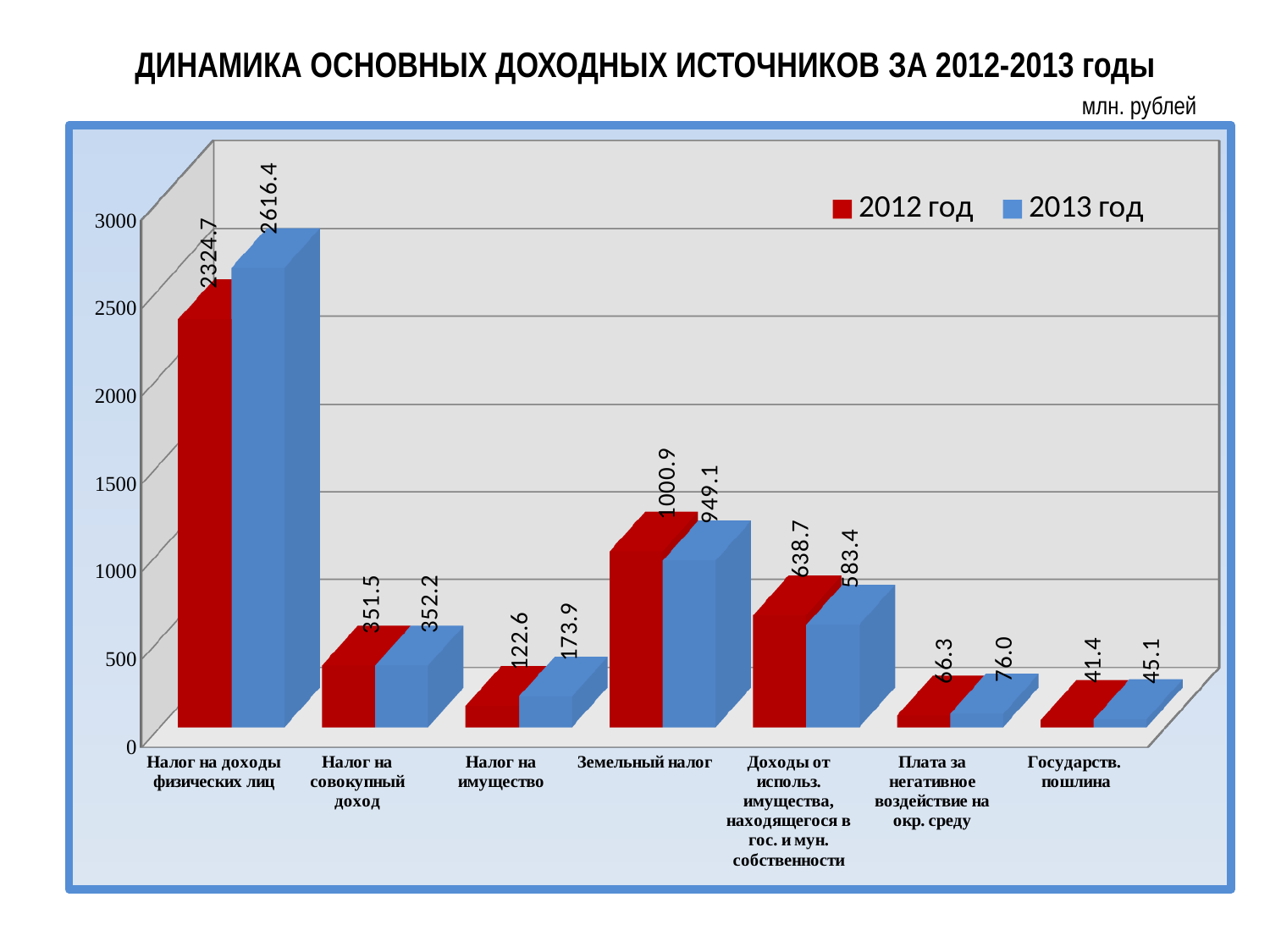
What is the value for 2013 год for Земельный налог? 949.1 How many series does the legend list? 2 Which is larger for Земельный налог: the 2012 год value or the 2013 год value? 2012 год What is the value for 2013 год for Налог на имущество? 173.9 What is the difference between the 2013 год and 2012 год values for Налог на доходы физических лиц? 291.7 What is the value for 2012 год for Плата за негативное воздействие на окр. среду? 66.3 What unit of measurement is indicated above the chart? млн. рублей How many categories are shown on the x axis? 7 Which category has the lowest value for 2012 год? Государств. пошлина What is the value for 2012 год for Налог на доходы физических лиц? 2324.7 Which category has the highest value for 2013 год? Налог на доходы физических лиц What kind of chart is shown on the slide? Bar chart